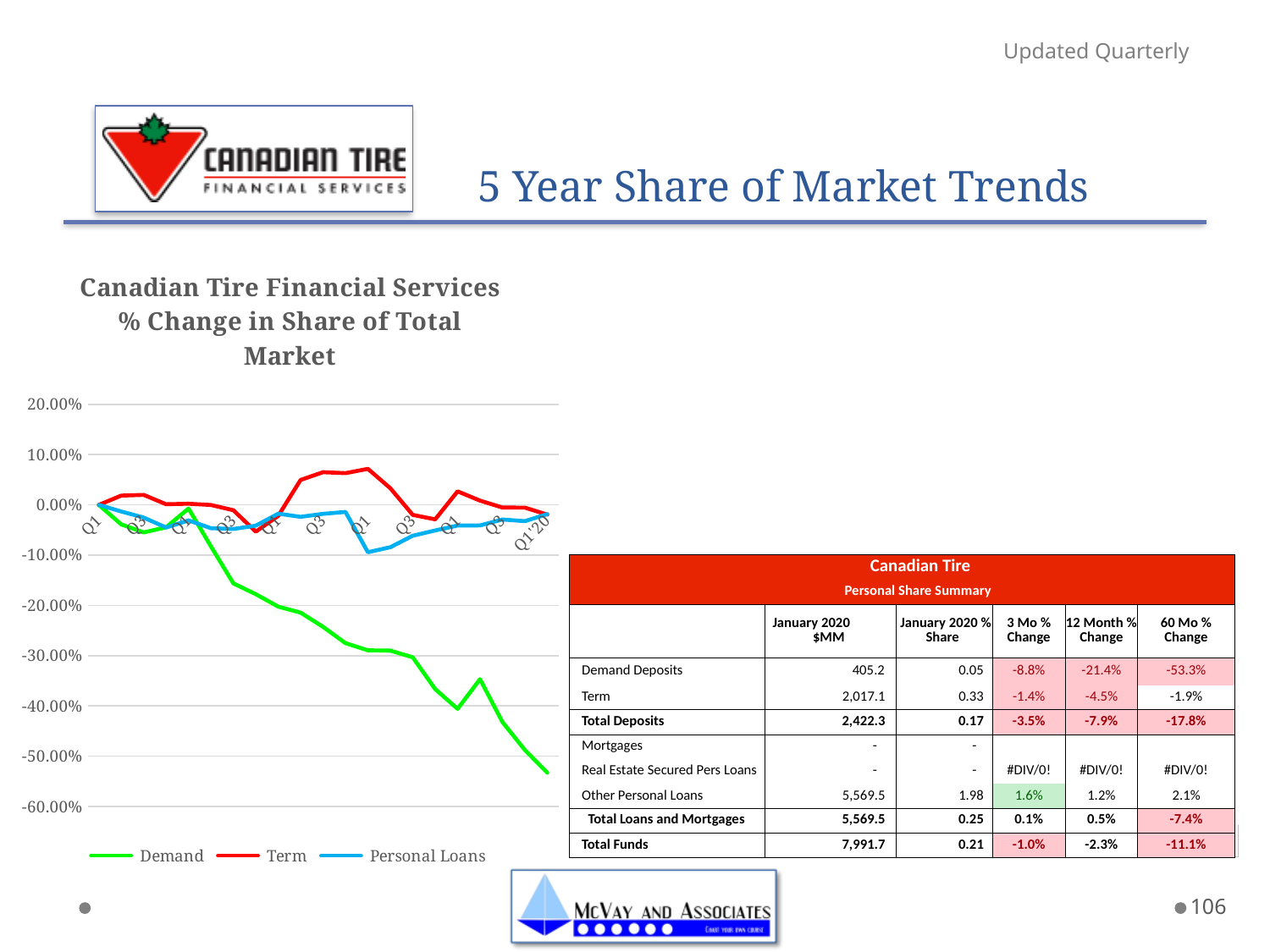
What kind of chart is shown on the slide? line chart Is the value for Demand at Q1'20 greater or less than -40.00%? less Is the highest value reached by the Term series greater or less than 10.00%? less At Q1'20, which is larger, the value for Term or the value for Demand? Term Does the Demand series rise or fall over the period shown on the x axis? fall What colour is the Demand line in the chart? green Is the lowest value of the Demand series greater or less than -60.00%? greater How many series does the chart legend list? 3 What are the three series named in the chart legend? Demand, Term, Personal Loans Which series reaches the highest value on the chart? Term Which series ends at the lowest value at Q1'20? Demand